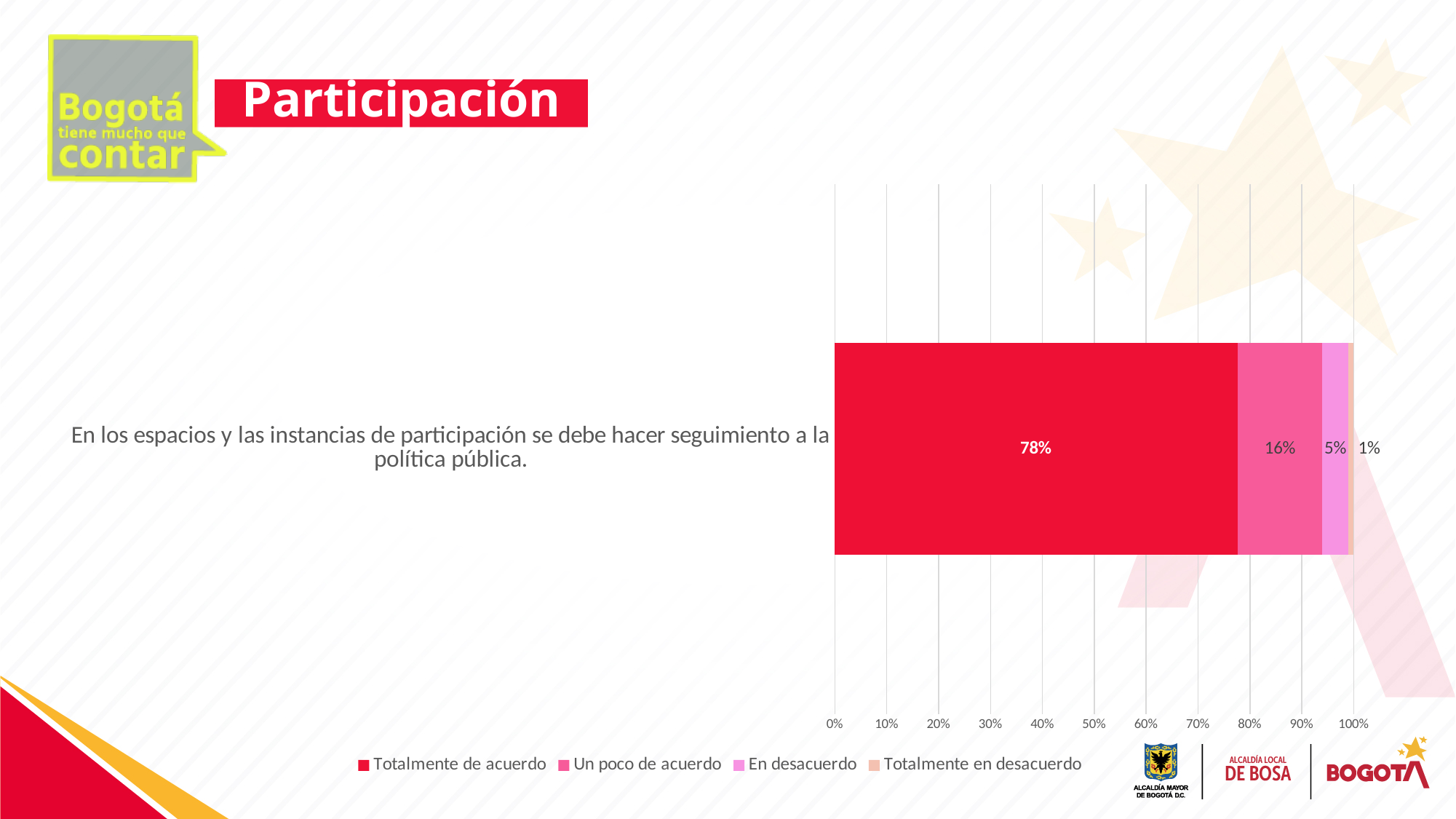
What kind of chart is shown on the slide? Stacked bar chart What percentage of respondents answered "Totalmente de acuerdo"? 78% What is the difference between the "Totalmente de acuerdo" and "Un poco de acuerdo" shares? 62% Which is larger, the share for "Un poco de acuerdo" or for "En desacuerdo"? Un poco de acuerdo Which response option has the lowest share? Totalmente en desacuerdo What percentage of respondents answered "Un poco de acuerdo"? 16% Is the value for "Totalmente de acuerdo" greater or less than 70%? greater How many series does the legend list? 4 What percentage of respondents answered "En desacuerdo"? 5% What percentage of respondents answered "Totalmente en desacuerdo"? 1% Which response option has the highest share? Totalmente de acuerdo What is the total of the stacked bar? 100%